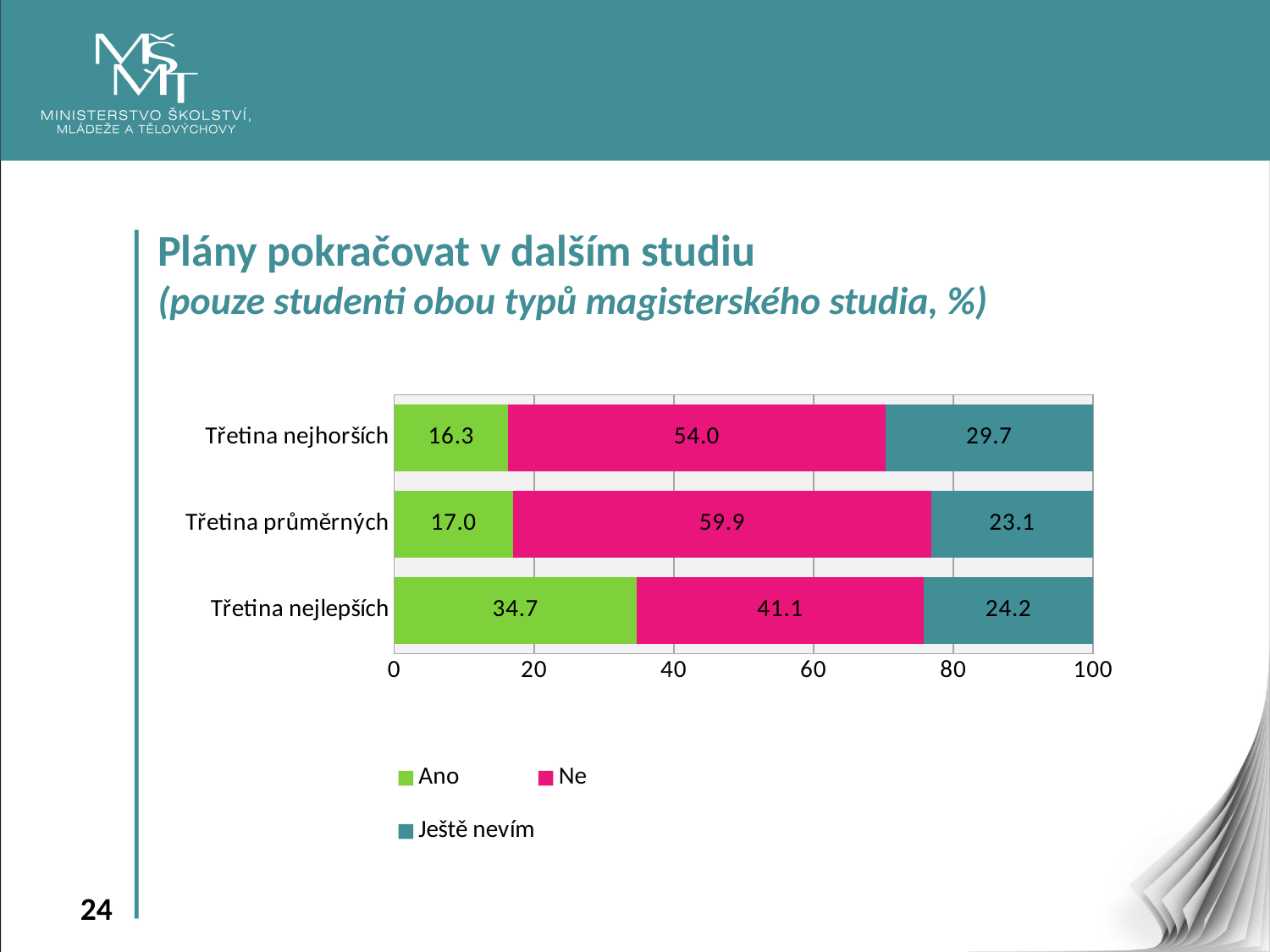
What is the value of "Ne" for "Třetina průměrných"? 59.9 Which category has the lowest value for "Ne"? Třetina nejlepších How many series does the legend list? 3 What kind of chart is shown on the slide? Stacked bar chart Which is larger: "Ještě nevím" for "Třetina nejlepších" or for "Třetina průměrných"? Třetina nejlepších How many categories are shown on the chart? 3 Which colour represents the "Ne" series in the legend? Pink What is the total of the stacked bar for "Třetina nejhorších"? 100.0 What is the value of "Ještě nevím" for "Třetina nejhorších"? 29.7 What is the difference between the "Ne" values for "Třetina průměrných" and "Třetina nejhorších"? 5.9 What is the value of "Ano" for "Třetina nejlepších"? 34.7 Which category has the highest value for "Ano"? Třetina nejlepších